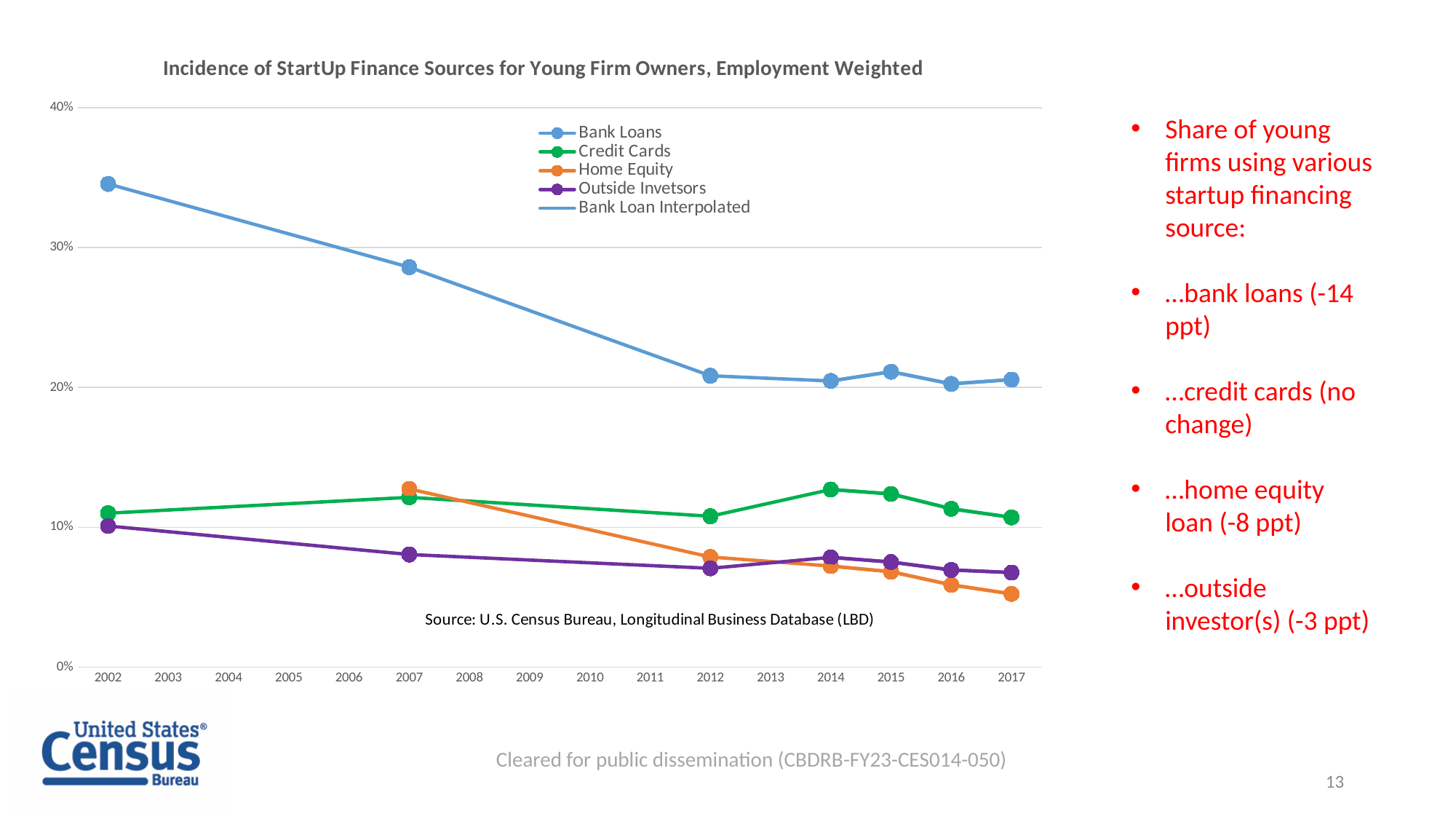
How many data points are plotted for the Credit Cards series? 7 Does the Bank Loans series rise or fall from 2002 to 2017? Fall What kind of chart is shown on the slide? Line chart What is the title of the chart? Incidence of StartUp Finance Sources for Young Firm Owners, Employment Weighted Is the value for Home Equity in 2017 greater or less than 10%? less How many series does the legend list? 5 Is the value for Bank Loans in 2002 greater or less than 30%? greater Which finance source has the lowest value in 2017? Home Equity Is the value for Bank Loans in 2012 greater or less than 20%? greater What colour is the Home Equity line in the chart? Orange In 2014, which is larger: Credit Cards or Outside Investors? Credit Cards Which finance source has the highest value in 2002? Bank Loans